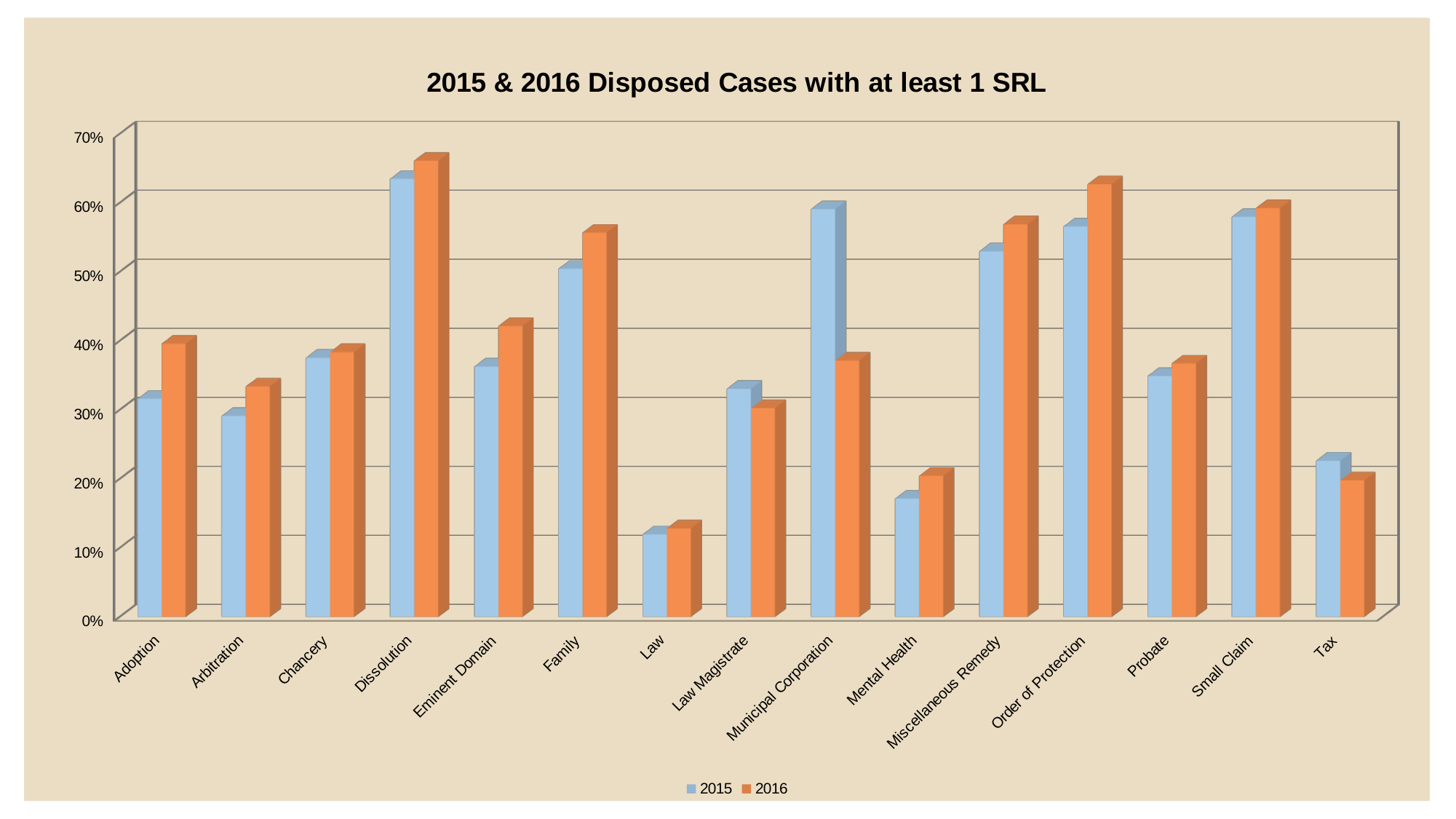
How many series does the legend list? 2 Is the 2015 value for Mental Health greater or less than 20%? less Which category has the lowest value for 2016? Law For Eminent Domain, which year has the larger value, 2015 or 2016? 2016 For Municipal Corporation, which year has the larger value, 2015 or 2016? 2015 Which category has the lowest value for 2015? Law What kind of chart is shown on the slide? bar chart What is the title of the chart? 2015 & 2016 Disposed Cases with at least 1 SRL Is the 2016 value for Family greater or less than 50%? greater How many case-type categories are shown on the x axis? 15 Is the 2016 value for Municipal Corporation greater or less than 40%? less Which category has the highest value for 2016? Dissolution